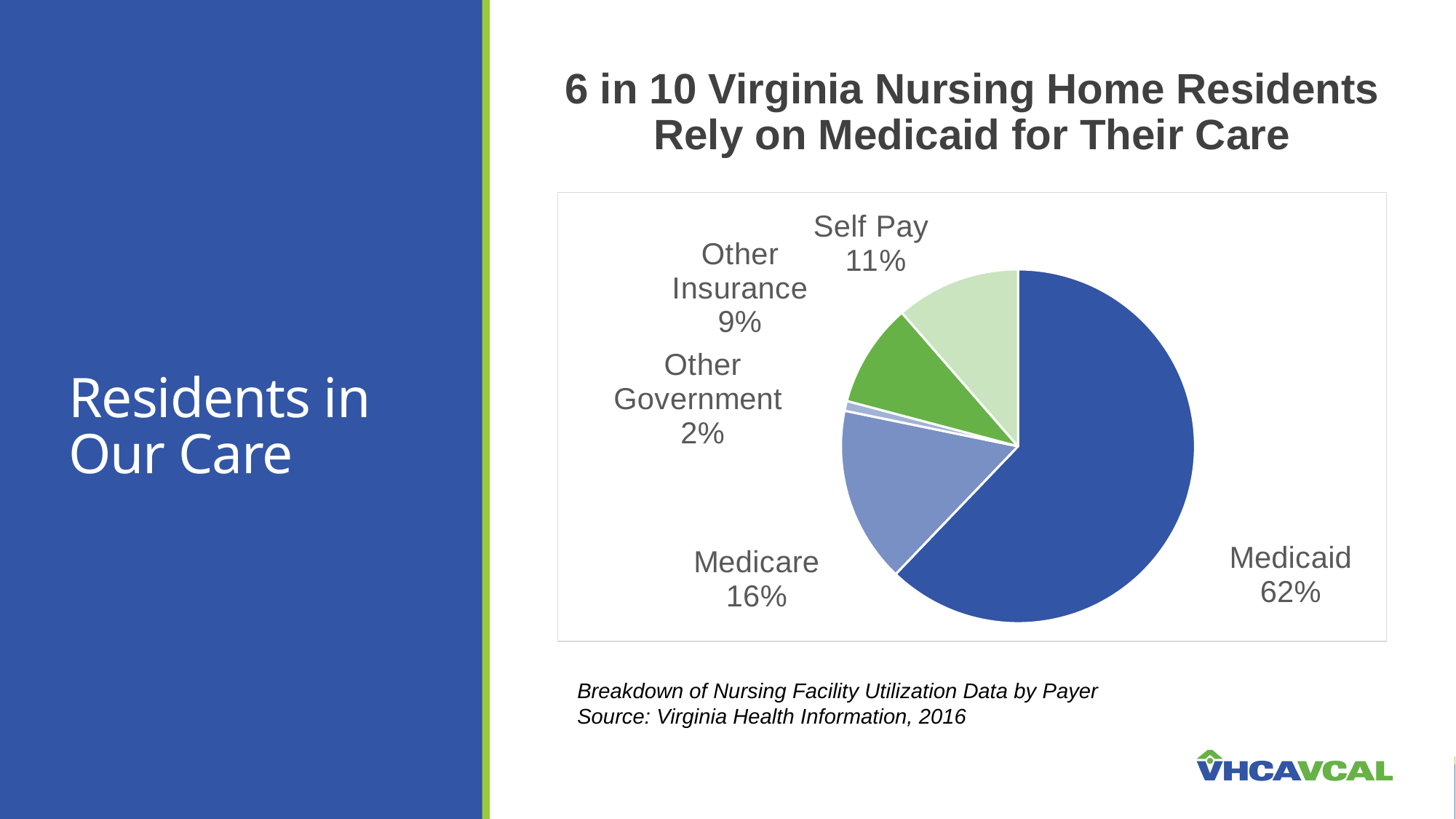
What percentage is shown for Medicare? 16% What percentage is shown for Self Pay? 11% Which is larger, the Self Pay slice or the Other Insurance slice? Self Pay How many payer categories are shown in the pie chart? 5 What is the title of the chart on the slide? 6 in 10 Virginia Nursing Home Residents Rely on Medicaid for Their Care Which payer has the smallest slice of the pie? Other Government What percentage is shown for Other Government? 2% What is the difference in percentage points between Medicaid and Medicare? 46 What percentage is shown for Other Insurance? 9% Which payer has the largest slice of the pie? Medicaid What kind of chart is shown on the slide? Pie chart What share of the pie does Medicaid account for? 62%